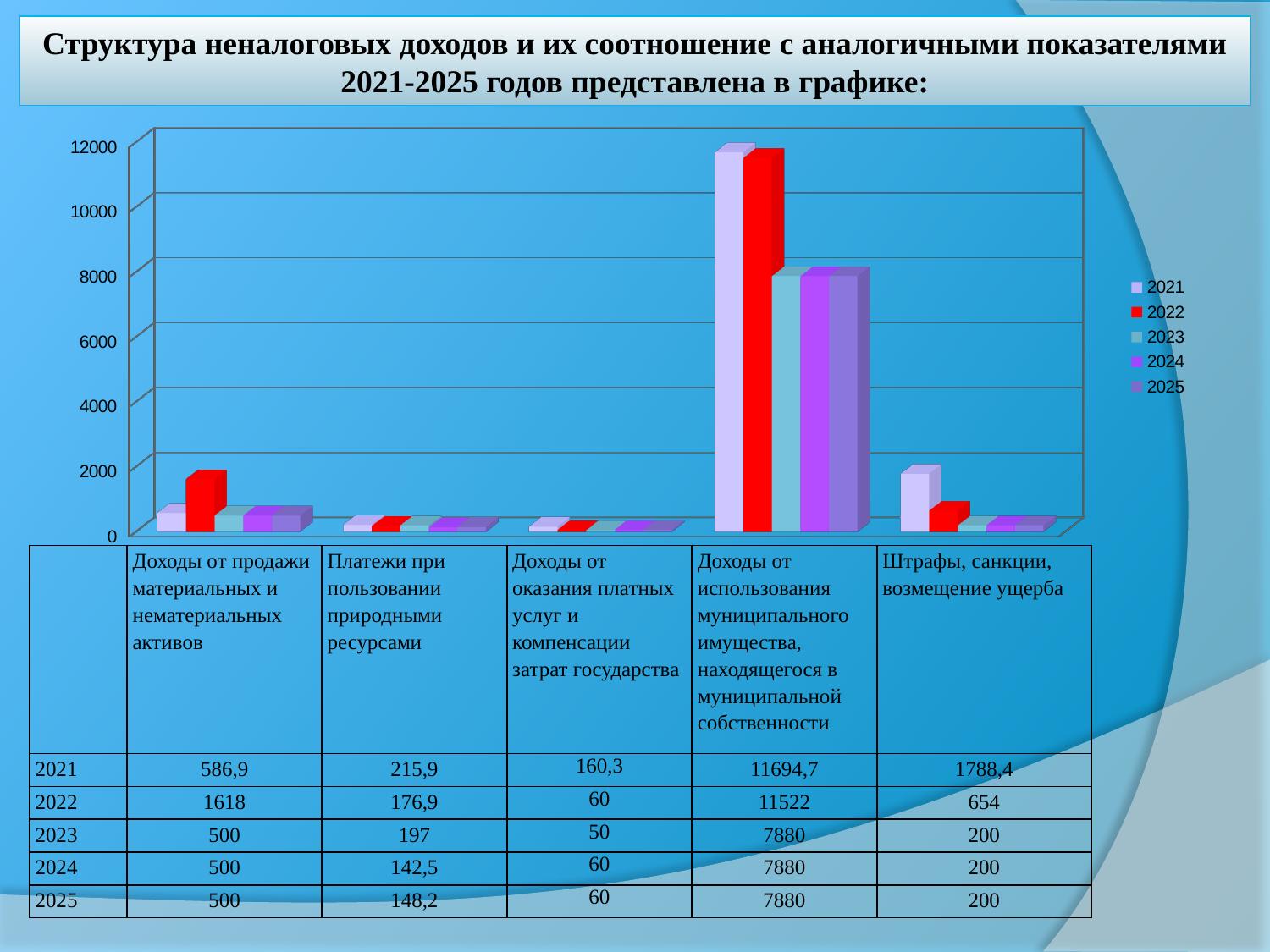
Is the 2023 value for "Доходы от использования муниципального имущества, находящегося в муниципальной собственности" greater or less than 6000? greater What is the difference between the 2021 and 2022 values for "Доходы от использования муниципального имущества, находящегося в муниципальной собственности"? 172,7 What is the value for 2022 in the category "Доходы от продажи материальных и нематериальных активов"? 1618 What is the value for 2021 in the category "Штрафы, санкции, возмещение ущерба"? 1788,4 What kind of chart is shown on the slide? bar chart How many series does the legend list? 5 What is the value for 2024 in the category "Платежи при пользовании природными ресурсами"? 142,5 Which category has the highest value for the 2022 series? Доходы от использования муниципального имущества, находящегося в муниципальной собственности Which is larger for "Штрафы, санкции, возмещение ущерба": the 2021 value or the 2022 value? 2021 What is the value for 2021 in the category "Доходы от использования муниципального имущества, находящегося в муниципальной собственности"? 11694,7 How many categories are shown on the x axis of the chart? 5 Which category has the lowest value for the 2023 series? Доходы от оказания платных услуг и компенсации затрат государства